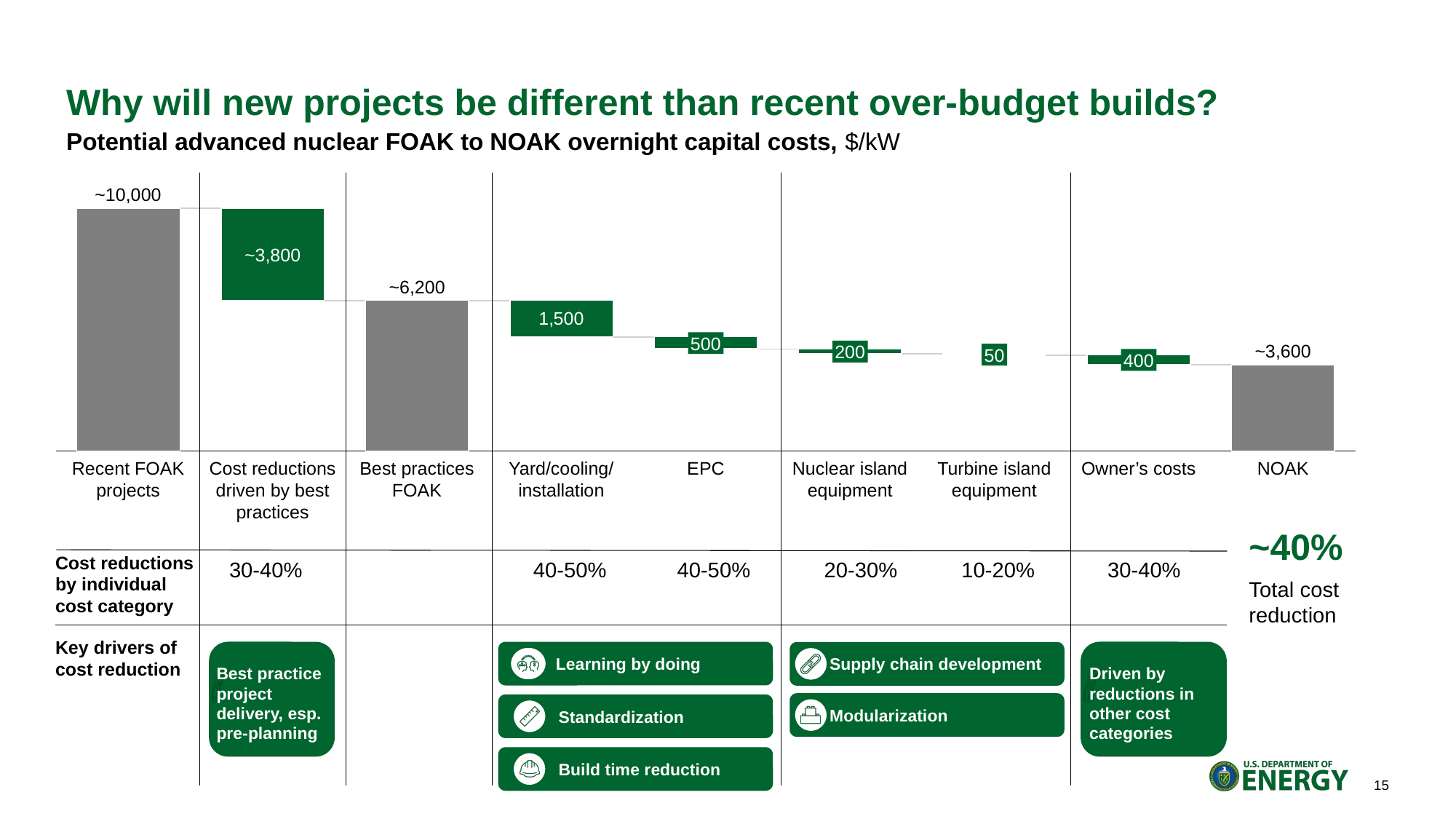
Which is larger, the value for EPC or the value for Owner's costs? EPC What is the value shown for Yard/cooling/installation? 1,500 What is the value shown for Owner's costs? 400 What is the value shown for Turbine island equipment? 50 What is the value shown for EPC? 500 How many categories are shown along the x axis of the chart? 9 What is the value shown for Nuclear island equipment? 200 What unit is the chart's data expressed in, according to the chart subtitle? $/kW Which category has the largest value in the chart? Recent FOAK projects Which category has the smallest value in the chart? Turbine island equipment What kind of chart is shown on the slide? Bar chart (waterfall) What is the difference between the Yard/cooling/installation value and the EPC value? 1,000